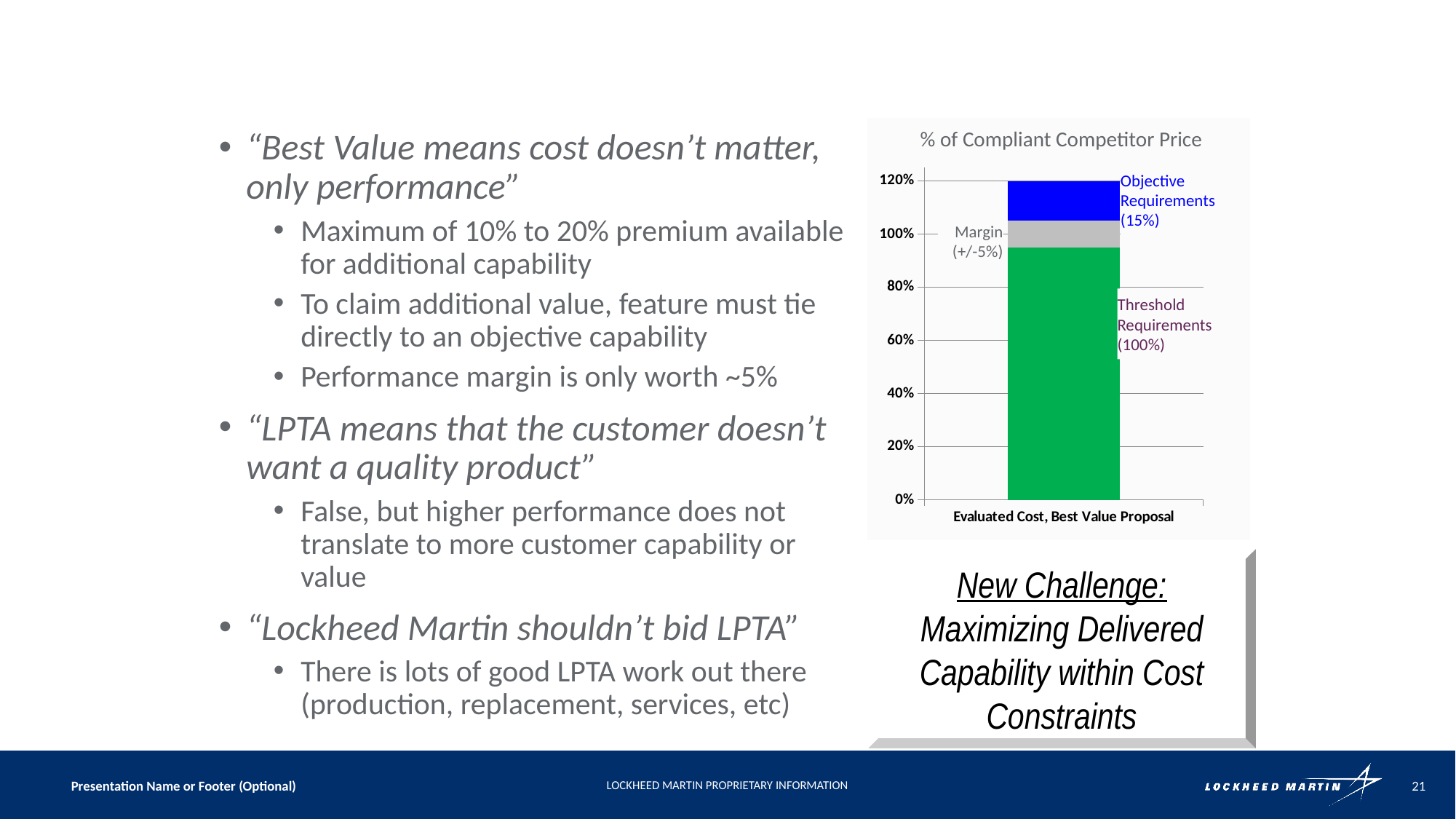
What percentage is given for Threshold Requirements in the chart? 100% What value on the y axis does the top of the stacked bar reach? 120% How many categories are plotted on the x axis of the chart? 1 Which segment of the stacked bar is larger, Objective Requirements or Threshold Requirements? Threshold Requirements Which segment of the stacked bar is the largest? Threshold Requirements What is the title of the chart? % of Compliant Competitor Price What percentage is given for Objective Requirements in the chart? 15% Which segment of the stacked bar is the smallest? Margin What kind of chart is shown on the slide? bar chart What value is given for Margin in the chart? +/-5% What colour represents Objective Requirements in the chart? blue Is the top of the green Threshold Requirements segment greater or less than 80%? greater